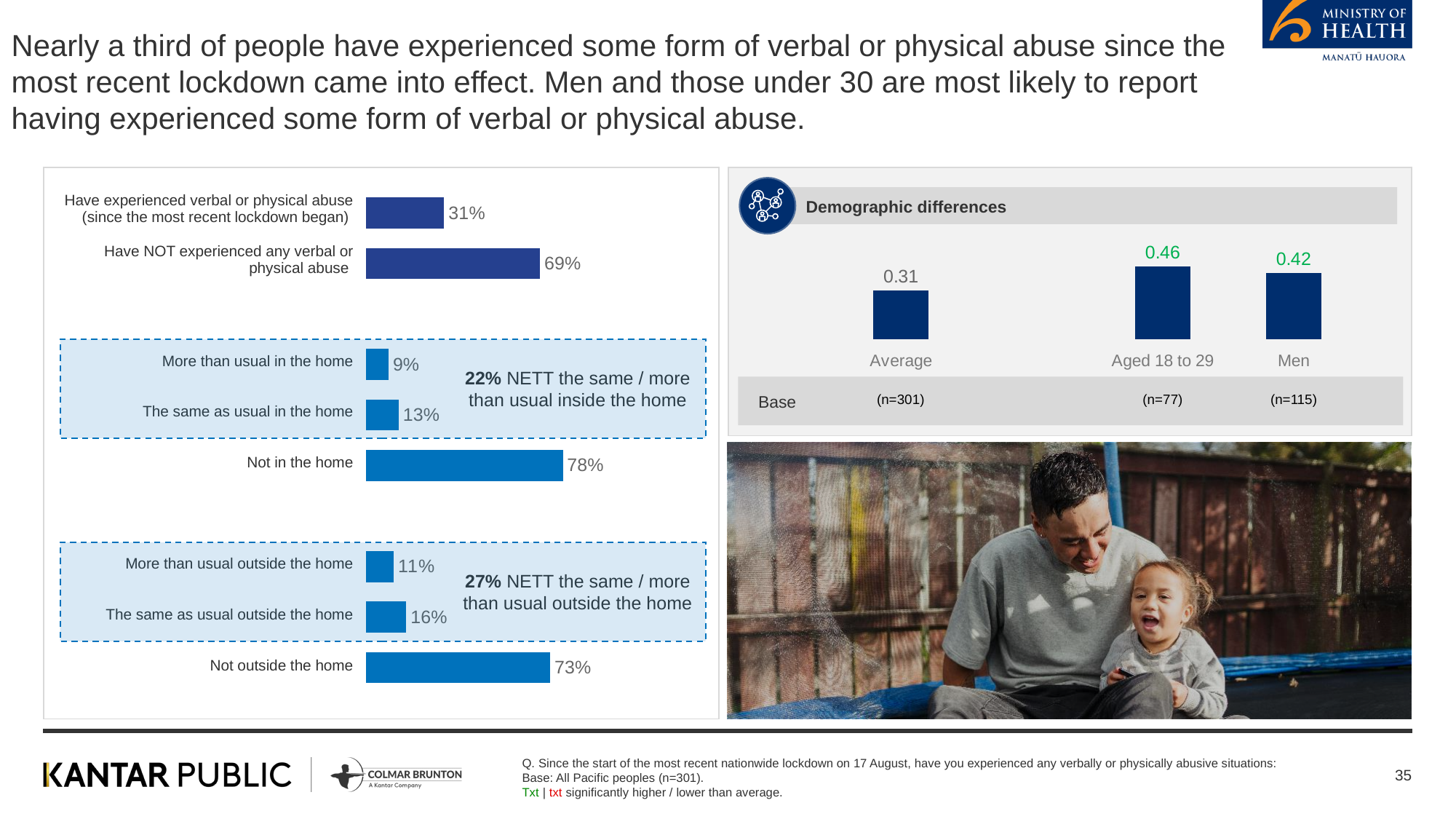
In the left bar chart, what is the value for 'Not in the home'? 78% In the left bar chart, which is larger: 'More than usual outside the home' or 'More than usual in the home'? More than usual outside the home In the 'Demographic differences' chart, what is the value for 'Aged 18 to 29'? 0.46 In the left bar chart, what is the value for 'The same as usual outside the home'? 16% In the left bar chart, what is the difference between 'Have NOT experienced any verbal or physical abuse' and 'Have experienced verbal or physical abuse'? 38 percentage points What type of chart is the left chart? Bar chart In the 'Demographic differences' chart, what is the value for 'Men'? 0.42 In the left bar chart, what percentage of people have experienced verbal or physical abuse since the most recent lockdown began? 31% In the left bar chart, which category has the highest value? Not in the home In the 'Demographic differences' chart, how many categories are shown? 3 In the 'Demographic differences' chart, what is the difference between 'Aged 18 to 29' and 'Average'? 0.15 In the left bar chart, which category has the lowest value? More than usual in the home